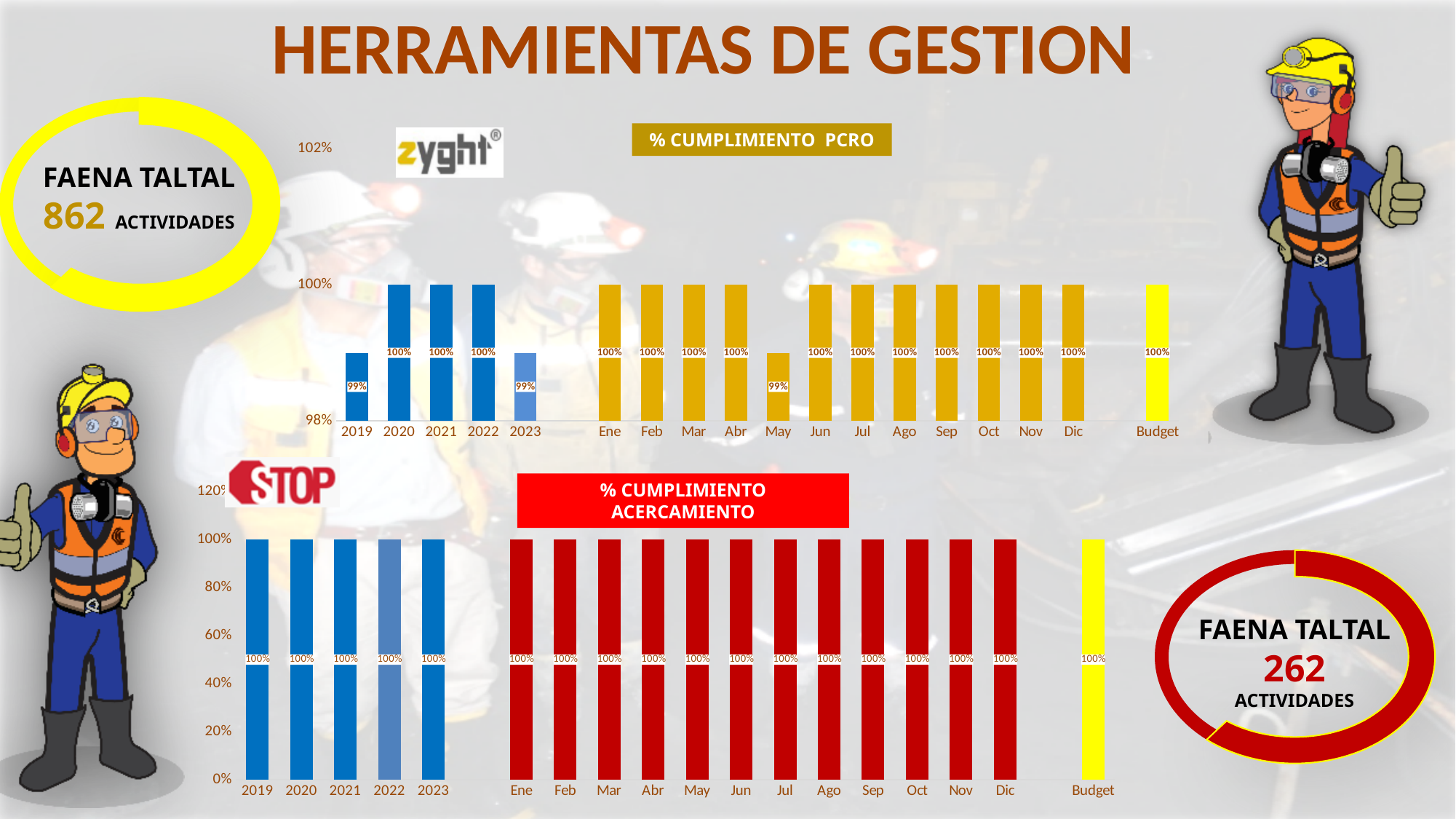
In the % CUMPLIMIENTO ACERCAMIENTO chart, what is the value for 2019? 100% In the % CUMPLIMIENTO PCRO chart, what is the value for 2019? 99% In the % CUMPLIMIENTO ACERCAMIENTO chart, what colour is the Budget bar? Yellow In the % CUMPLIMIENTO PCRO chart, what is the value for 2021? 100% In the % CUMPLIMIENTO PCRO chart, what is the value for Budget? 100% In the % CUMPLIMIENTO ACERCAMIENTO chart, how many bars are plotted? 18 What kind of chart is the % CUMPLIMIENTO ACERCAMIENTO chart? Bar chart In the % CUMPLIMIENTO PCRO chart, what is the difference between the values for 2020 and 2023? 1% In the % CUMPLIMIENTO PCRO chart, what is the value for May? 99% In the % CUMPLIMIENTO ACERCAMIENTO chart, what is the value for Jul? 100% In the % CUMPLIMIENTO PCRO chart, which is larger, the value for 2022 or the value for 2023? 2022 In the % CUMPLIMIENTO PCRO chart, which month has the lowest value? May